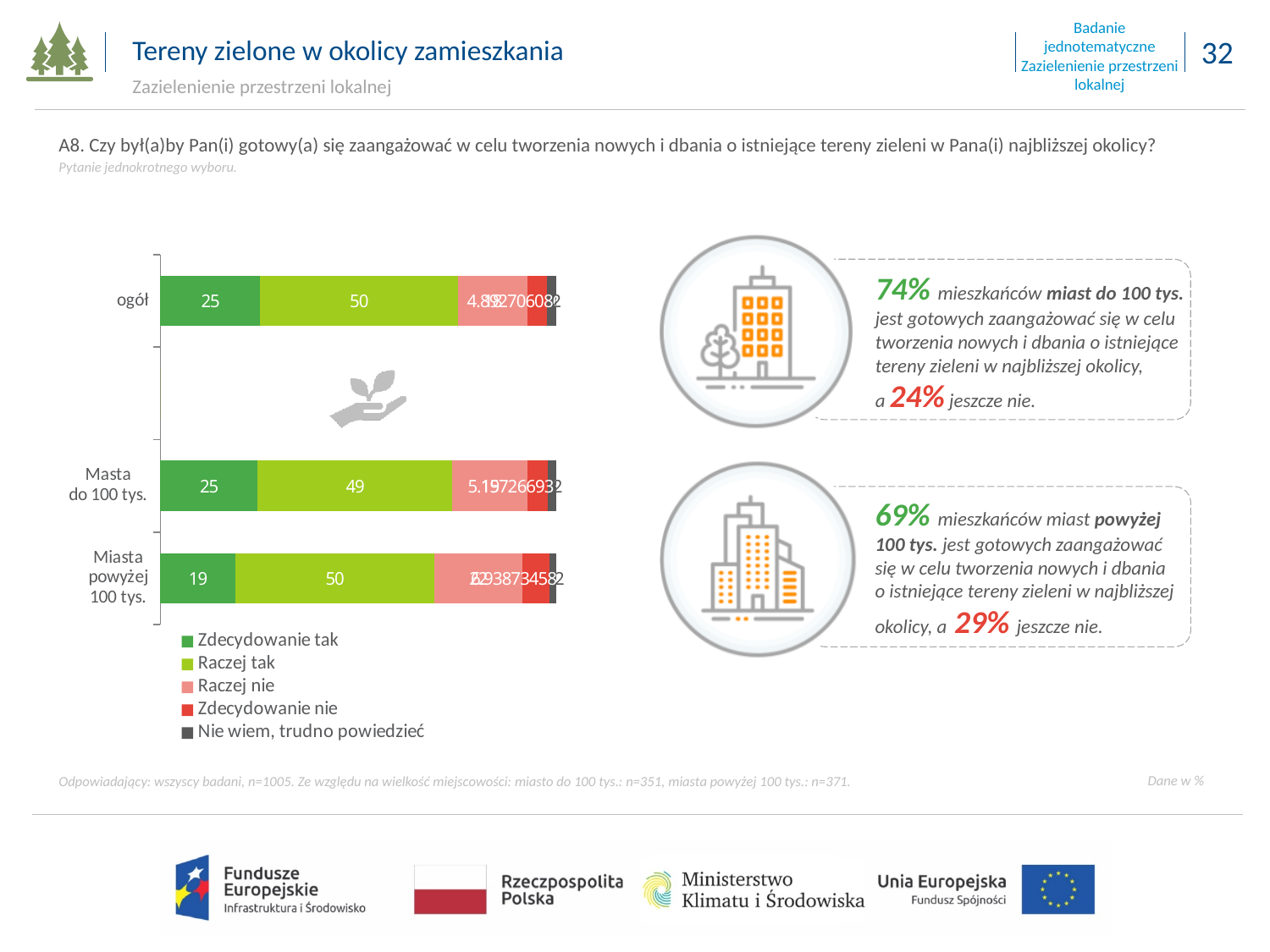
How many series does the chart legend list? 5 How many categories are plotted on the chart? 3 Which category has the lowest value for "Zdecydowanie tak"? Miasta powyżej 100 tys. What is the value of "Raczej tak" for "Miasta powyżej 100 tys."? 50 What is the value of "Zdecydowanie tak" for "ogół"? 25 What is the value of "Raczej tak" for "ogół"? 50 What is the value of "Zdecydowanie tak" for "Miasta powyżej 100 tys."? 19 What is the difference between the "Zdecydowanie tak" values for "ogół" and "Miasta powyżej 100 tys."? 6 What type of chart is shown on the slide? stacked bar chart For "ogół", which is larger: "Zdecydowanie tak" or "Raczej tak"? Raczej tak What is the value of "Raczej tak" for "Miasta do 100 tys."? 49 Which legend entry is shown in dark grey? Nie wiem, trudno powiedzieć